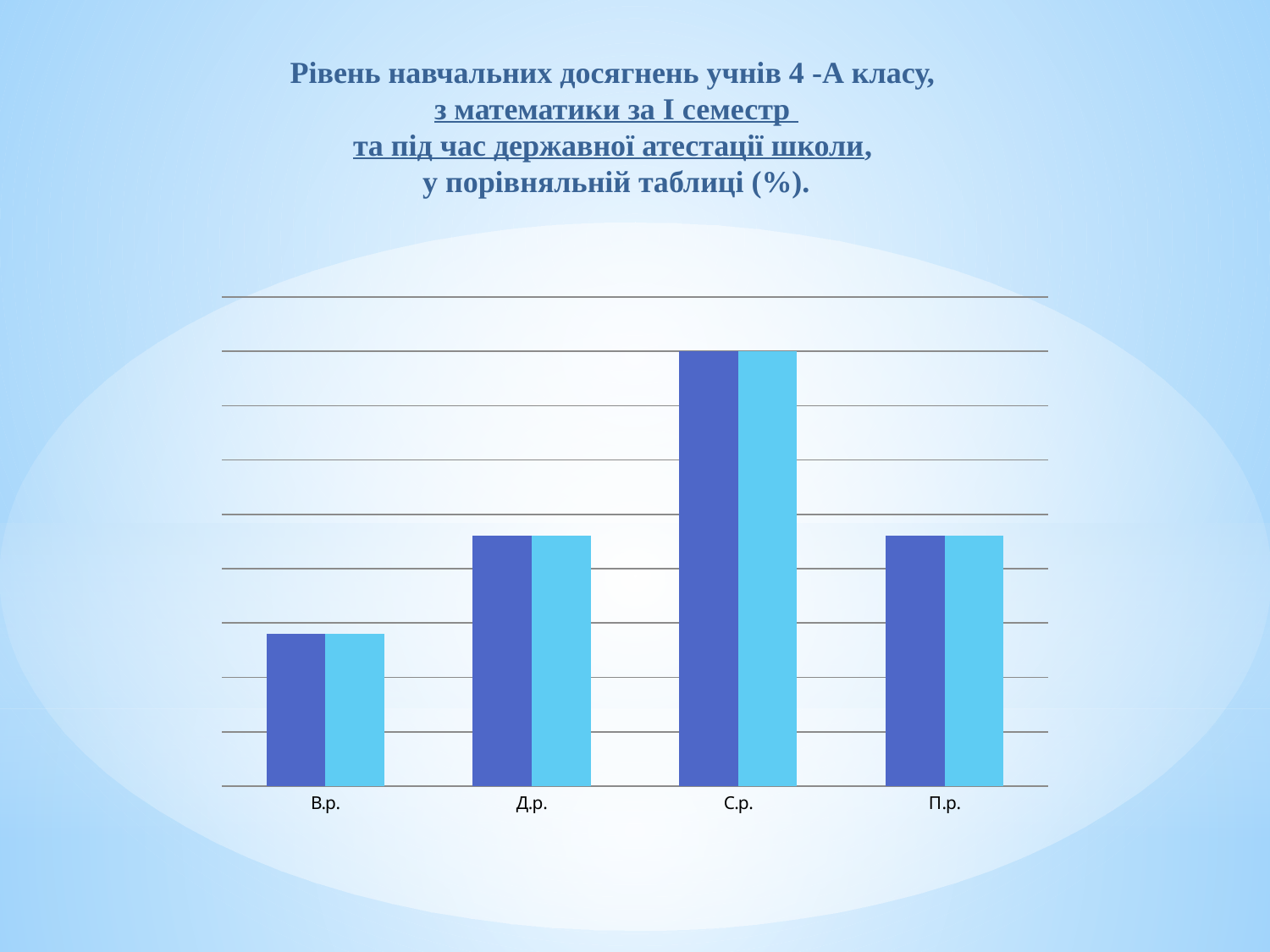
Which category has higher bars, С.р. or Д.р.? С.р. Which category has higher bars, В.р. or П.р.? П.р. What is the label of the third category on the x axis? С.р. Which category has the highest bars in the chart? С.р. How many bars are shown for each category in the chart? 2 Which category has lower bars, В.р. or Д.р.? В.р. Which category has the lowest bars in the chart? В.р. How many categories are shown on the x axis of the chart? 4 What kind of chart is shown on the slide? bar chart